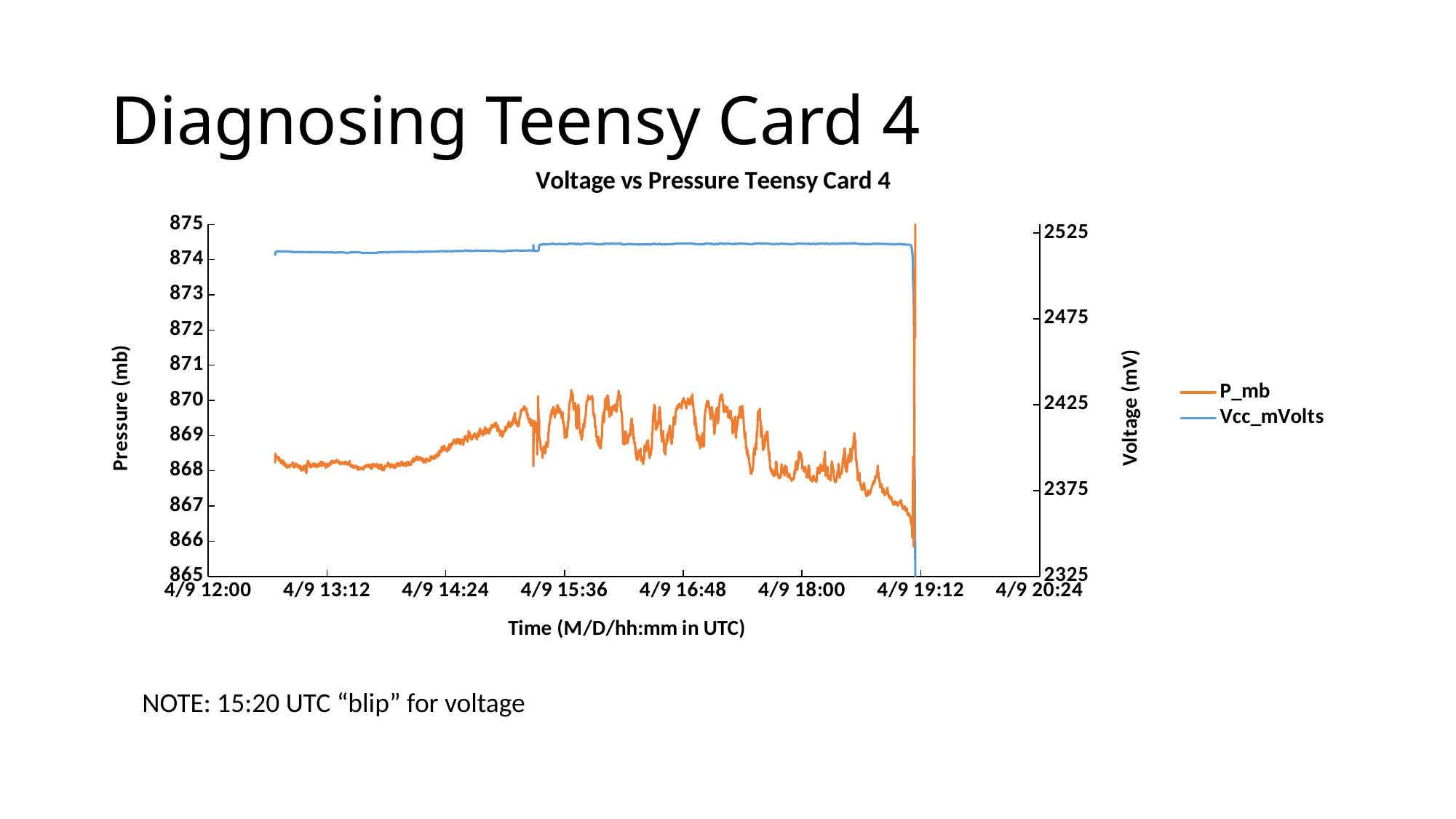
Is the value of P_mb at 4/9 13:12 greater or less than 869? less Which series is plotted in orange? P_mb Which is larger, the P_mb value at 4/9 16:48 or at 4/9 13:12? 4/9 16:48 Does P_mb generally rise or fall between 4/9 16:48 and 4/9 19:12? fall What is the title of the chart? Voltage vs Pressure Teensy Card 4 How many series does the legend list? 2 Is the value of Vcc_mVolts at 4/9 14:24 greater or less than 2475? greater What kind of chart is shown on the slide? Line chart Is the value of Vcc_mVolts at 4/9 16:48 greater or less than 2500? greater What is the label of the left vertical axis? Pressure (mb) Does P_mb generally rise or fall between 4/9 13:12 and 4/9 15:36? rise